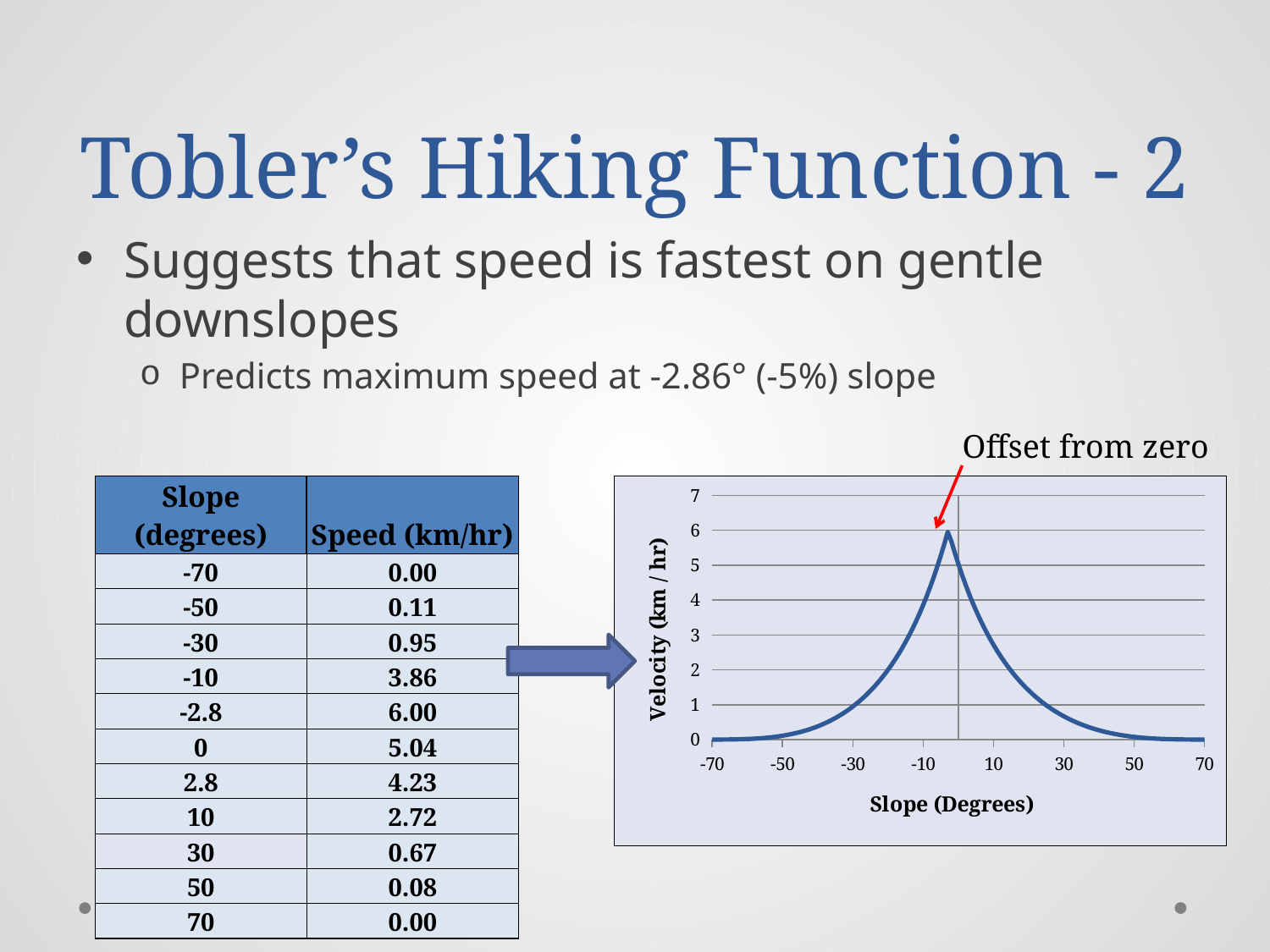
On the chart, is the velocity at a slope of -10 degrees larger or smaller than the velocity at 10 degrees? larger On the chart, is the velocity at a slope of 10 degrees greater or less than 2? greater On the chart, is the velocity at a slope of -10 degrees greater or less than 3? greater On the chart, is the peak velocity greater or less than 5? greater What is the title of the y axis of the chart? Velocity (km / hr) What is the title of the x axis of the chart? Slope (Degrees) On the chart, does velocity rise or fall as slope increases from -70 to -10 degrees? rise What kind of chart is shown on the right of the slide? line chart On the chart, does velocity rise or fall as slope increases from 10 to 70 degrees? fall